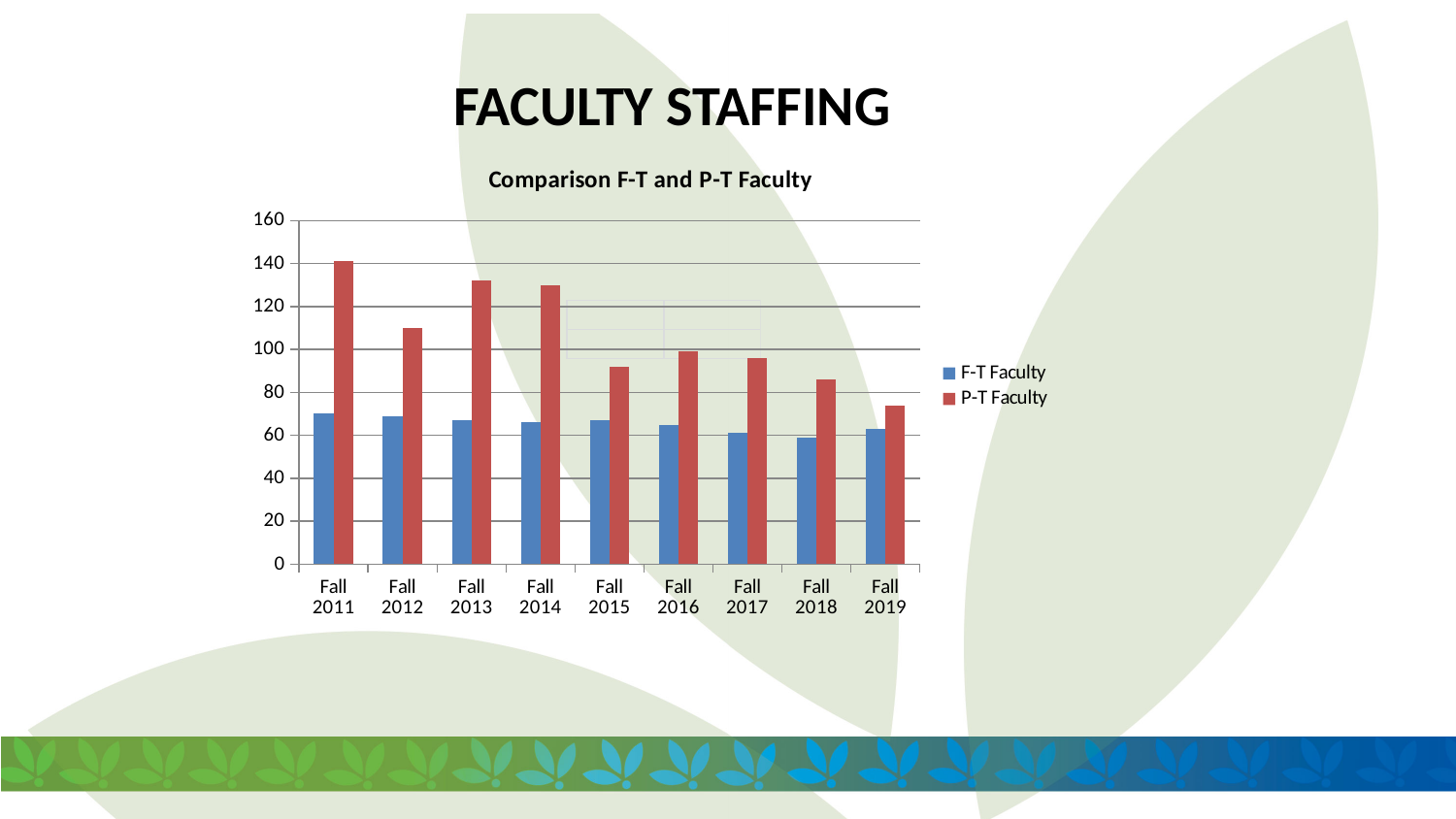
In which Fall term is the P-T Faculty value highest? Fall 2011 In Fall 2011, which is larger, F-T Faculty or P-T Faculty? P-T Faculty Is the P-T Faculty value for Fall 2011 greater or less than 120? greater How many Fall terms are shown on the x axis? 9 Is the P-T Faculty value for Fall 2019 greater or less than 80? less What kind of chart is shown on the slide? bar chart In which Fall term is the P-T Faculty value lowest? Fall 2019 Which series is shown in red? P-T Faculty What is the title of the chart? Comparison F-T and P-T Faculty How many series does the legend list? 2 Is the F-T Faculty value for Fall 2011 greater or less than 60? greater Overall, do the P-T Faculty values rise or fall from Fall 2011 to Fall 2019? fall